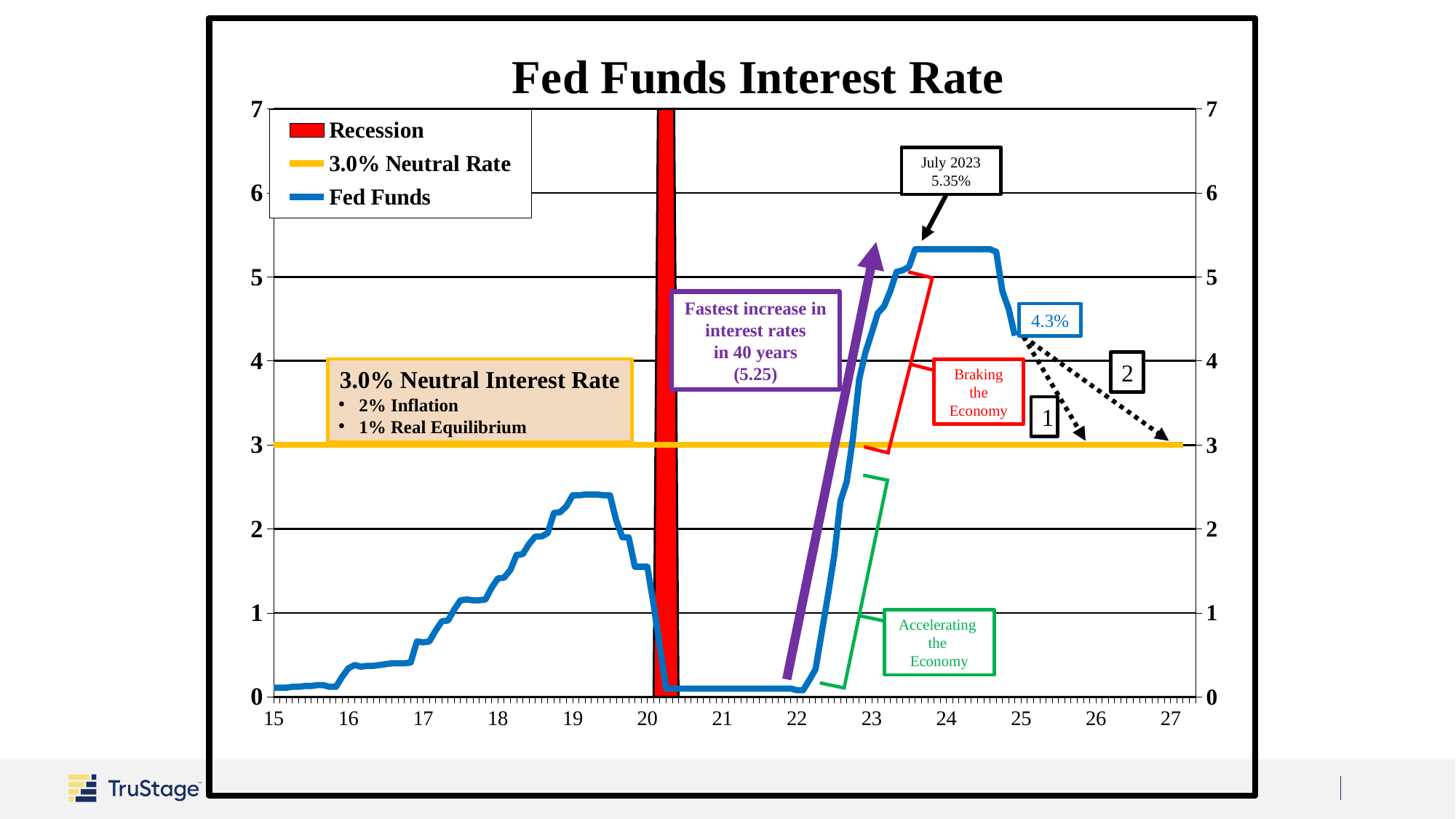
What is the difference between the July 2023 rate of 5.35% and the 3.0% neutral rate? 2.35% What Fed Funds rate is labeled on the chart near 2025? 4.3% How many entries does the chart's legend list? 3 Is the Fed Funds rate in 2024 greater or less than 5? greater Which is larger, the Fed Funds rate in 2019 or in 2024? 2024 What Fed Funds rate is labeled for July 2023? 5.35% Does the Fed Funds line rise or fall between 22 and 23 on the x axis? rise What colour is the Fed Funds line? blue What is the title of the chart? Fed Funds Interest Rate Is the Fed Funds rate in 2019 greater or less than 3? less What kind of chart is shown on the slide? line chart What is the neutral rate shown by the yellow horizontal line? 3.0%